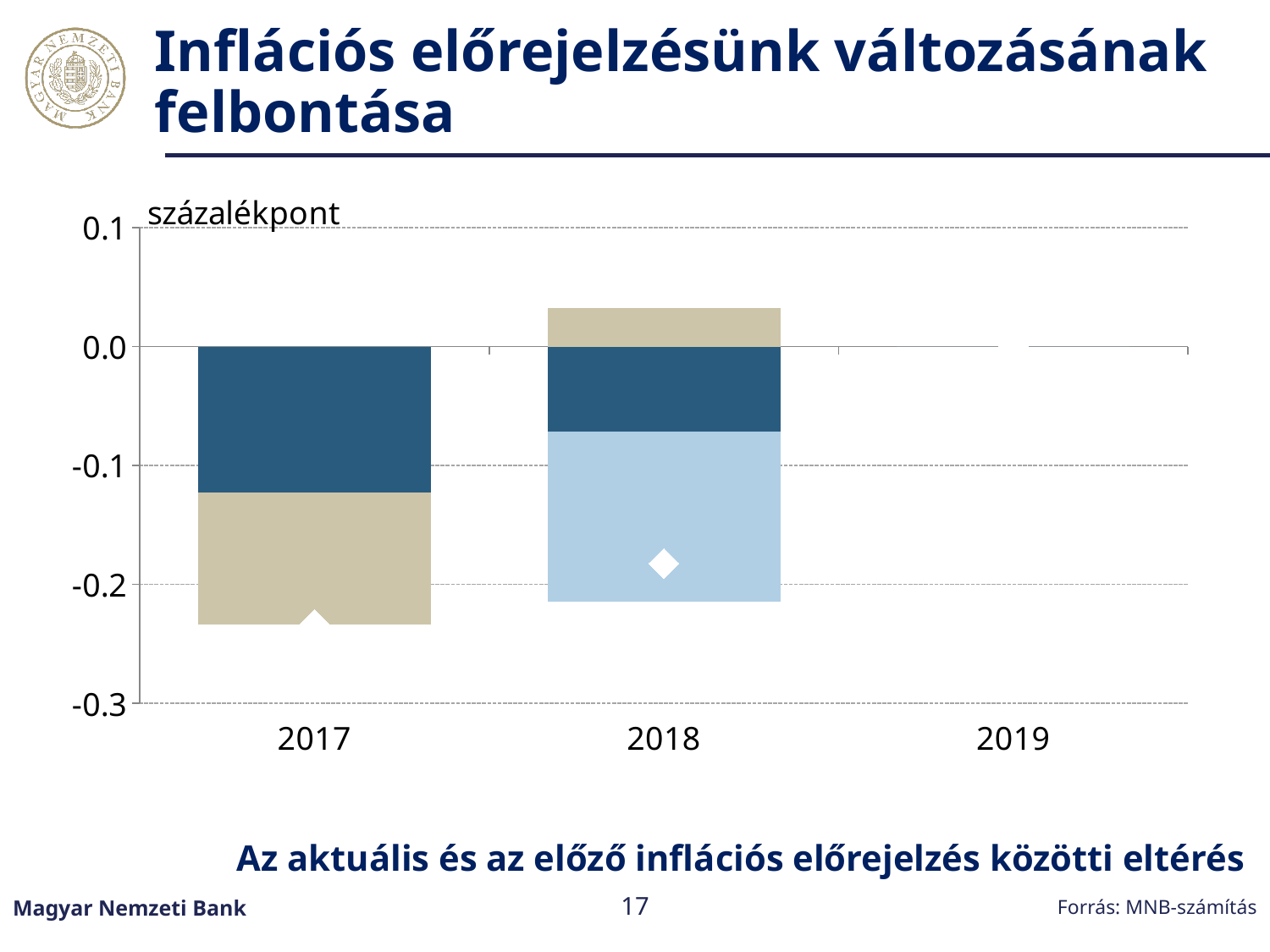
Which year has a segment extending above 0.0? 2018 What kind of chart is shown on the slide? bar chart How many years are shown on the x axis of the chart? 3 Is the top of the positive segment of the 2018 bar greater or less than 0.1? less Which year on the x axis has no visible bar? 2019 What is the caption shown below the chart? Az aktuális és az előző inflációs előrejelzés közötti eltérés Is the bottom of the stacked bar for 2018 greater or less than -0.1? less Is the bottom of the stacked bar for 2017 greater or less than -0.2? less What unit label is shown at the top of the y axis? százalékpont